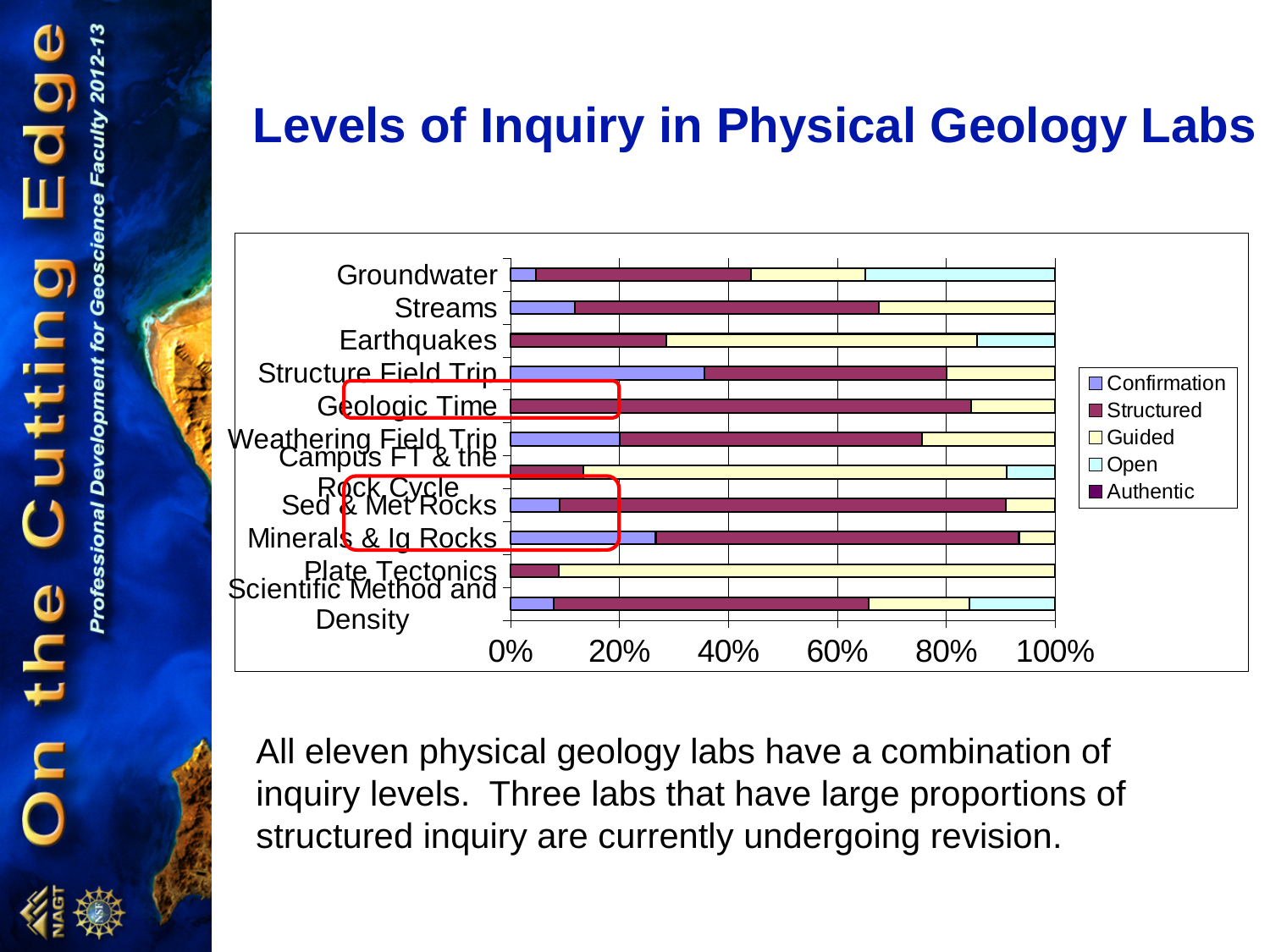
Is the Structured share for Earthquakes greater or less than 20%? greater Which has the larger Structured share, Geologic Time or Earthquakes? Geologic Time Which has the larger Confirmation share, Structure Field Trip or Streams? Structure Field Trip How many series does the legend list? 5 Which lab has the largest Guided share? Plate Tectonics Which inquiry level is listed last in the legend? Authentic What is the total of the Groundwater stacked bar? 100% What kind of chart is shown on the slide? Stacked bar chart How many lab categories are plotted on the chart? 11 Is the Guided share for Plate Tectonics greater or less than 80%? greater What is the title of the slide's chart? Levels of Inquiry in Physical Geology Labs Is the Confirmation share for Structure Field Trip greater or less than 20%? greater